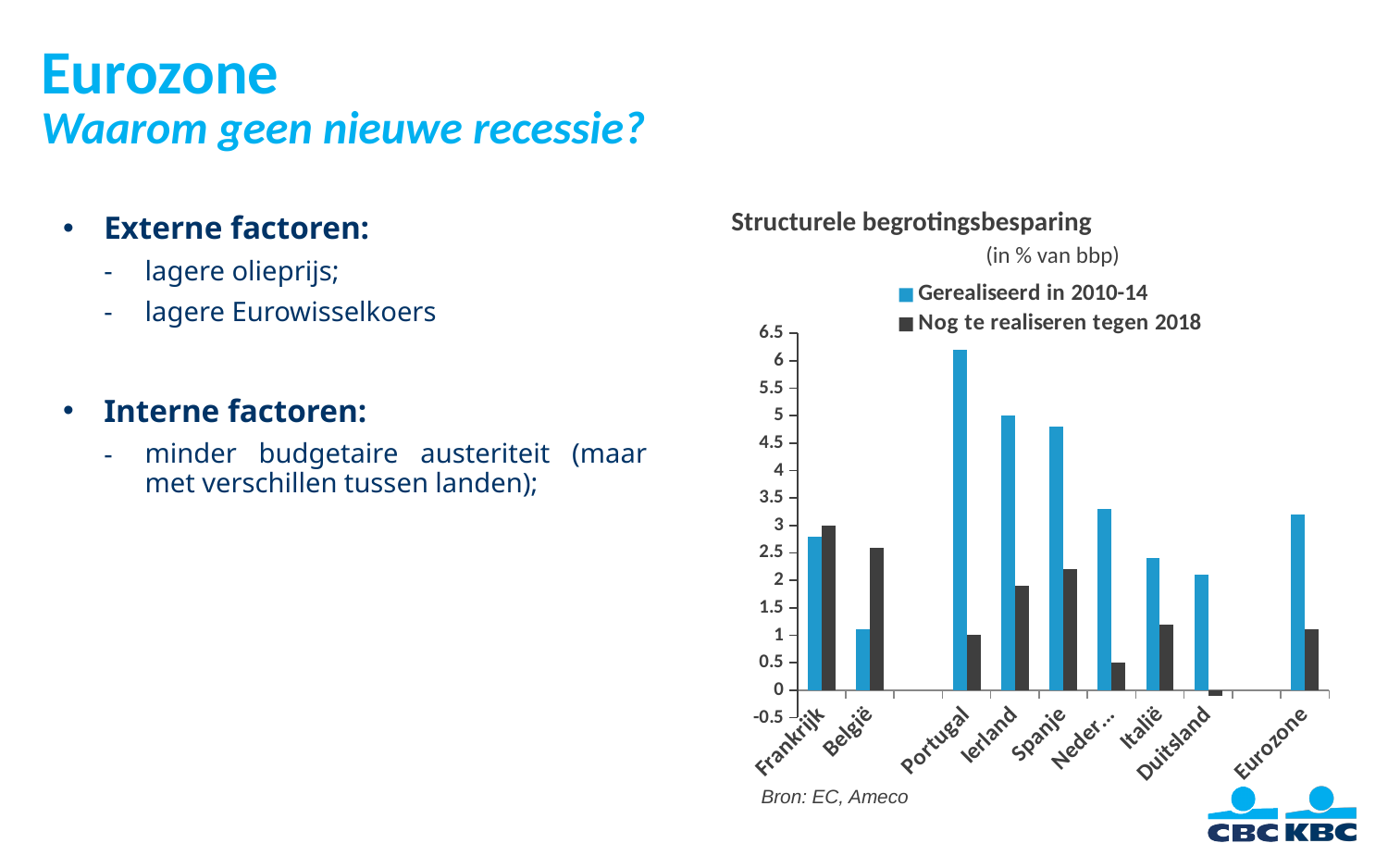
How many series does the legend of the chart list? 2 Which is larger: the 'Gerealiseerd in 2010-14' value for Ierland or the 'Nog te realiseren tegen 2018' value for Spanje? Gerealiseerd in 2010-14 for Ierland Which category has the highest value for 'Nog te realiseren tegen 2018'? Frankrijk Which category has the lowest value for 'Gerealiseerd in 2010-14'? België What kind of chart is shown on the slide? bar chart Which category has the lowest value for 'Nog te realiseren tegen 2018'? Duitsland Is the 'Gerealiseerd in 2010-14' value for België greater or less than 1.5? less What is the title of the chart? Structurele begrotingsbesparing Which category has the highest value for 'Gerealiseerd in 2010-14'? Portugal Is the 'Gerealiseerd in 2010-14' value for Portugal greater or less than 5.5? greater For België, which is larger: 'Gerealiseerd in 2010-14' or 'Nog te realiseren tegen 2018'? Nog te realiseren tegen 2018 How many countries/regions are shown on the x axis of the chart? 9